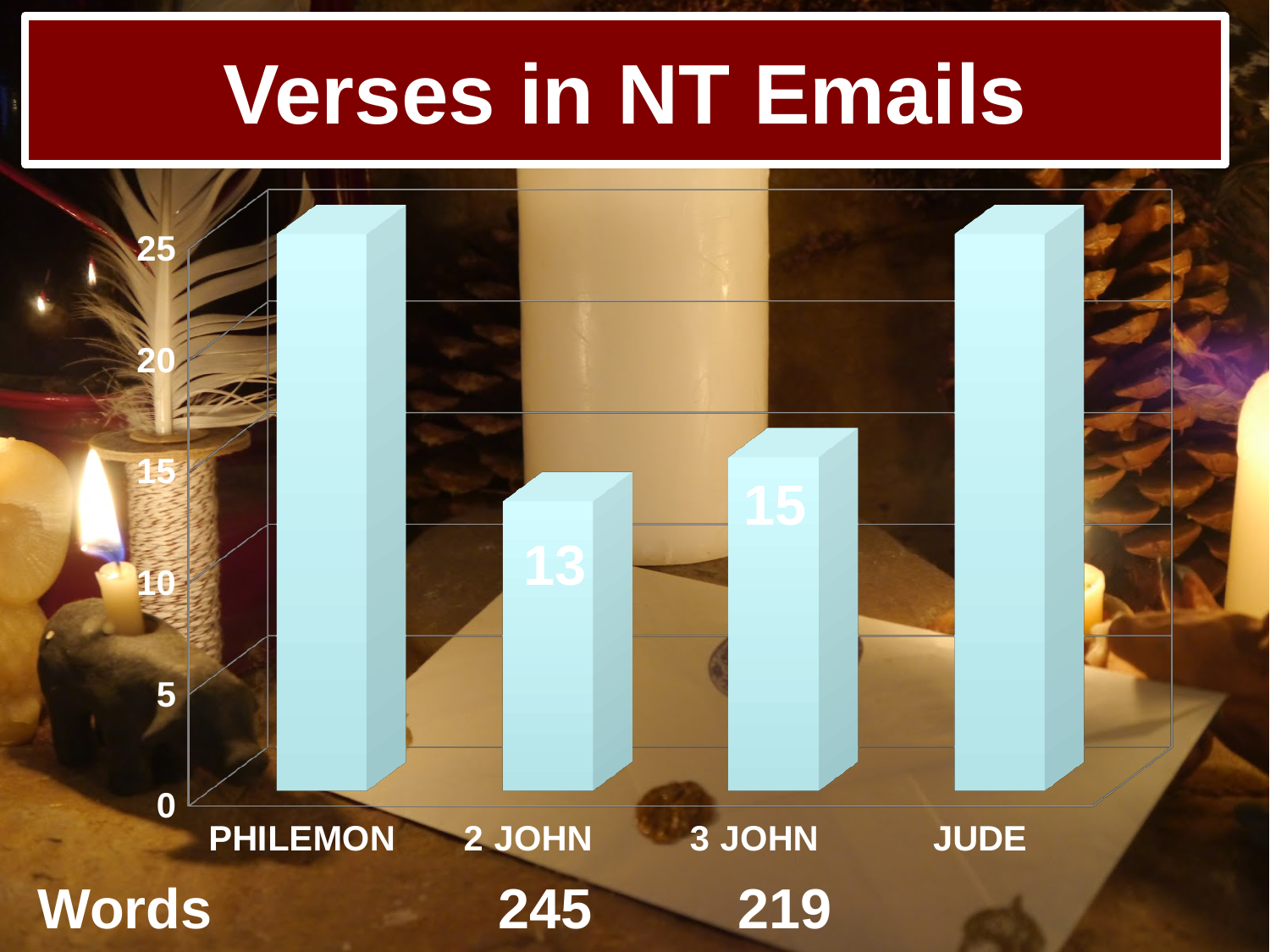
What kind of chart is shown on the slide? bar chart Is the value for PHILEMON greater or less than 20? greater Which category has the lowest value? 2 JOHN What is the value for 3 JOHN? 15 Which has a larger value, 2 JOHN or 3 JOHN? 3 JOHN Is the value for JUDE greater or less than 20? greater What is the value for 2 JOHN? 13 What is the difference between the values for 3 JOHN and 2 JOHN? 2 What is the title of the chart? Verses in NT Emails How many categories are shown on the x axis? 4 What is the label of the first category on the x axis? PHILEMON Is the value for 2 JOHN greater or less than 15? less